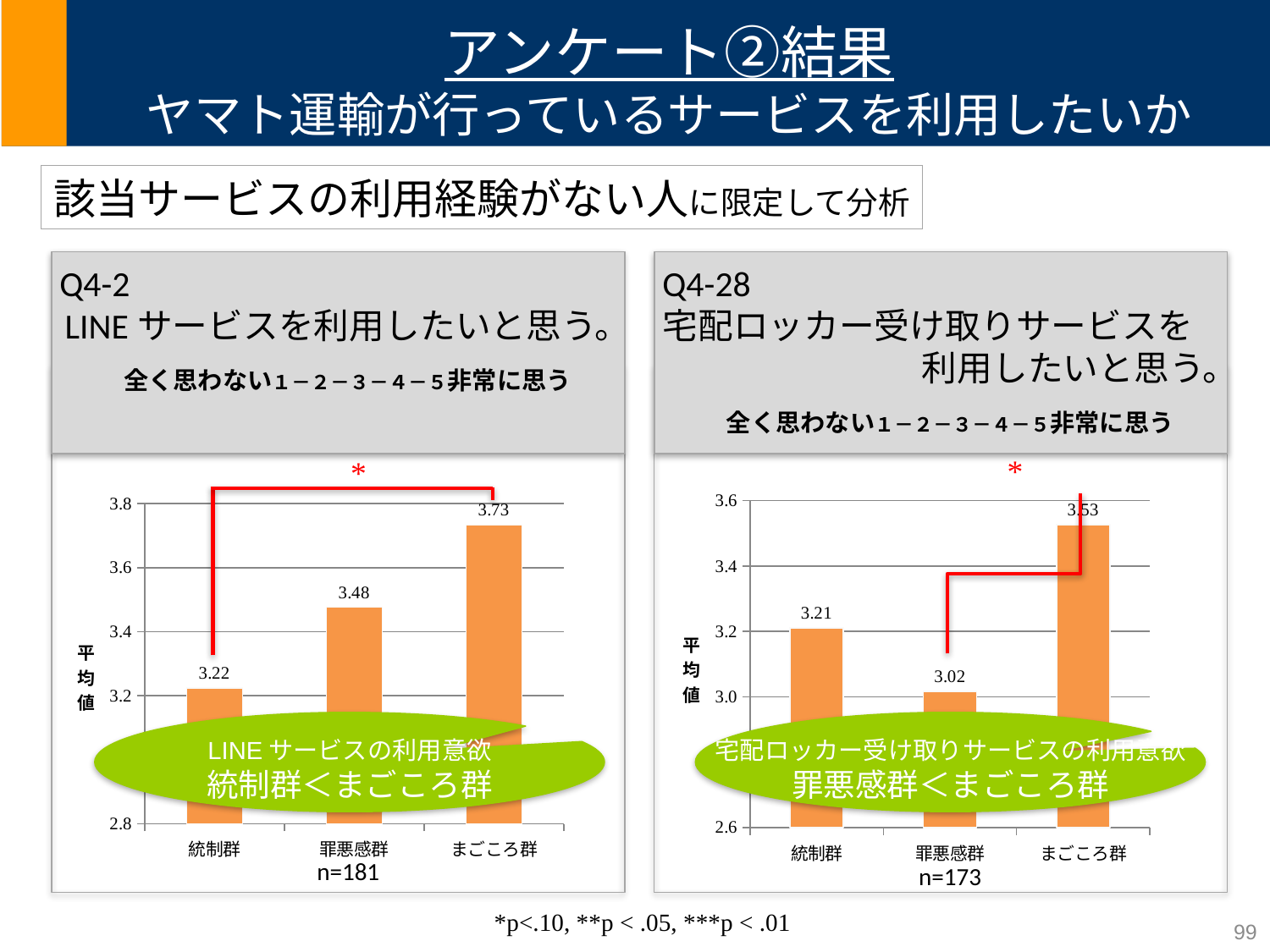
In the left chart (Q4-2, LINE service), what is the difference between the mean values of まごころ群 and 統制群? 0.51 In the left chart (Q4-2, LINE service), do the values rise or fall from 統制群 to まごころ群 along the x axis? rise How many groups (categories) are shown on the x axis of the left chart (Q4-2)? 3 In the left chart (Q4-2, LINE service), what is the mean value for まごころ群? 3.73 In the left chart (Q4-2, LINE service), which group has the highest mean value? まごころ群 In the left chart (Q4-2, LINE service), what is the mean value for 統制群? 3.22 In the right chart (Q4-28, delivery locker service), which group has the lowest mean value? 罪悪感群 In the right chart (Q4-28, delivery locker service), what is the difference between the mean values of まごころ群 and 罪悪感群? 0.51 In the right chart (Q4-28, delivery locker service), which is larger, the mean value for 統制群 or for 罪悪感群? 統制群 In the right chart (Q4-28, delivery locker service), what is the mean value for まごころ群? 3.53 In the right chart (Q4-28, delivery locker service), what is the mean value for 罪悪感群? 3.02 What type of chart is used in the right chart (Q4-28)? bar chart